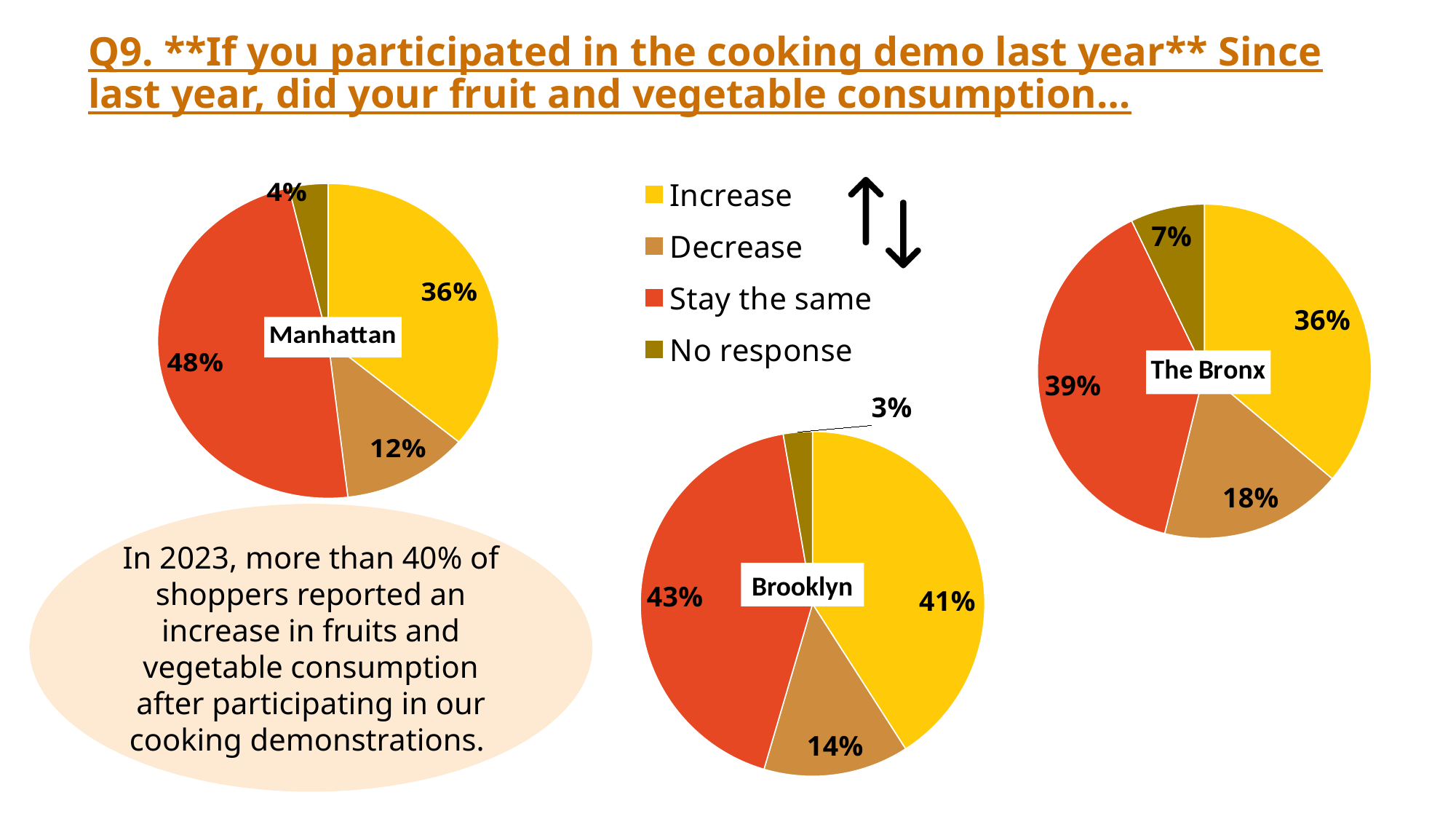
In the Manhattan pie chart, what is the difference between the Stay the same share and the Increase share? 12% In The Bronx pie chart, which category has the smallest share? No response In the Brooklyn pie chart, what share of respondents gave no response? 3% What kind of chart is used to show the Brooklyn data? Pie chart In the Manhattan pie chart, what share of respondents reported an increase in fruit and vegetable consumption? 36% In the Brooklyn pie chart, what share of respondents said their consumption stayed the same? 43% How many categories does the legend list? 4 Which colour represents the Decrease category in the legend? Brown/tan In the Brooklyn pie chart, which is larger: the Increase slice or the Decrease slice? Increase In The Bronx pie chart, what is the difference between the Increase share and the Decrease share? 18% In The Bronx pie chart, what share of respondents reported a decrease? 18% In the Manhattan pie chart, which category has the largest share? Stay the same